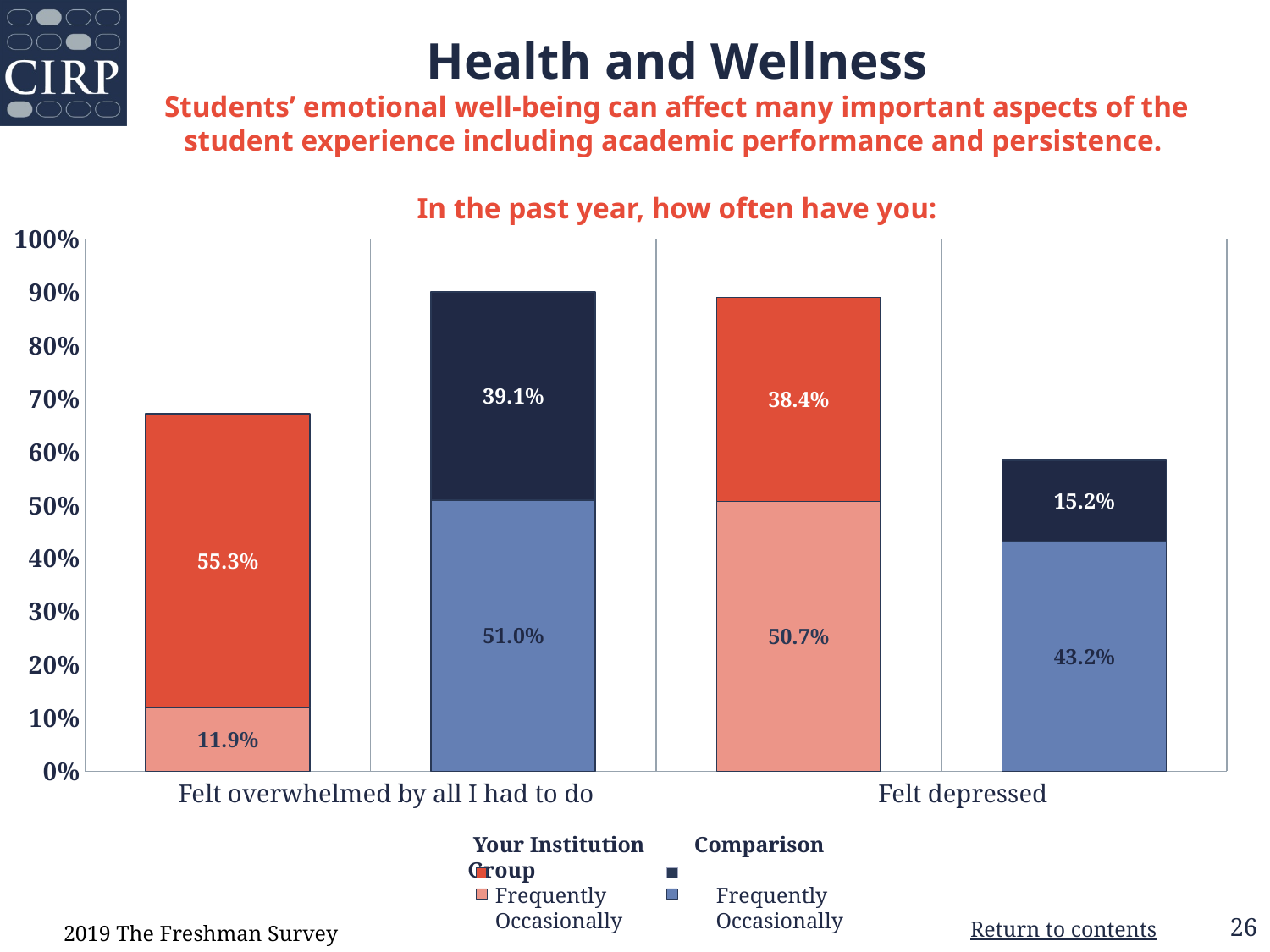
What is the difference between the 'Frequently' percentages for Your Institution and the Comparison Group for 'Felt overwhelmed by all I had to do'? 16.2% What percentage of students at Your Institution reported occasionally feeling overwhelmed by all they had to do? 11.9% Which group has the larger 'Occasionally' percentage for 'Felt depressed', Your Institution or the Comparison Group? Your Institution What type of chart is shown on the slide? Stacked bar chart What is the combined percentage (frequently plus occasionally) of the Comparison Group who felt overwhelmed by all they had to do? 90.1% How many survey items (categories) are shown on the x axis? 2 Which bar has the lowest combined total on the chart? Comparison Group, Felt depressed What percentage of students at Your Institution reported frequently feeling overwhelmed by all they had to do? 55.3% What percentage of the Comparison Group reported frequently feeling depressed? 15.2% How many series does the legend list? 4 What percentage of the Comparison Group reported occasionally feeling overwhelmed by all they had to do? 51.0% What is the combined percentage (frequently plus occasionally) of Your Institution students who felt depressed? 89.1%